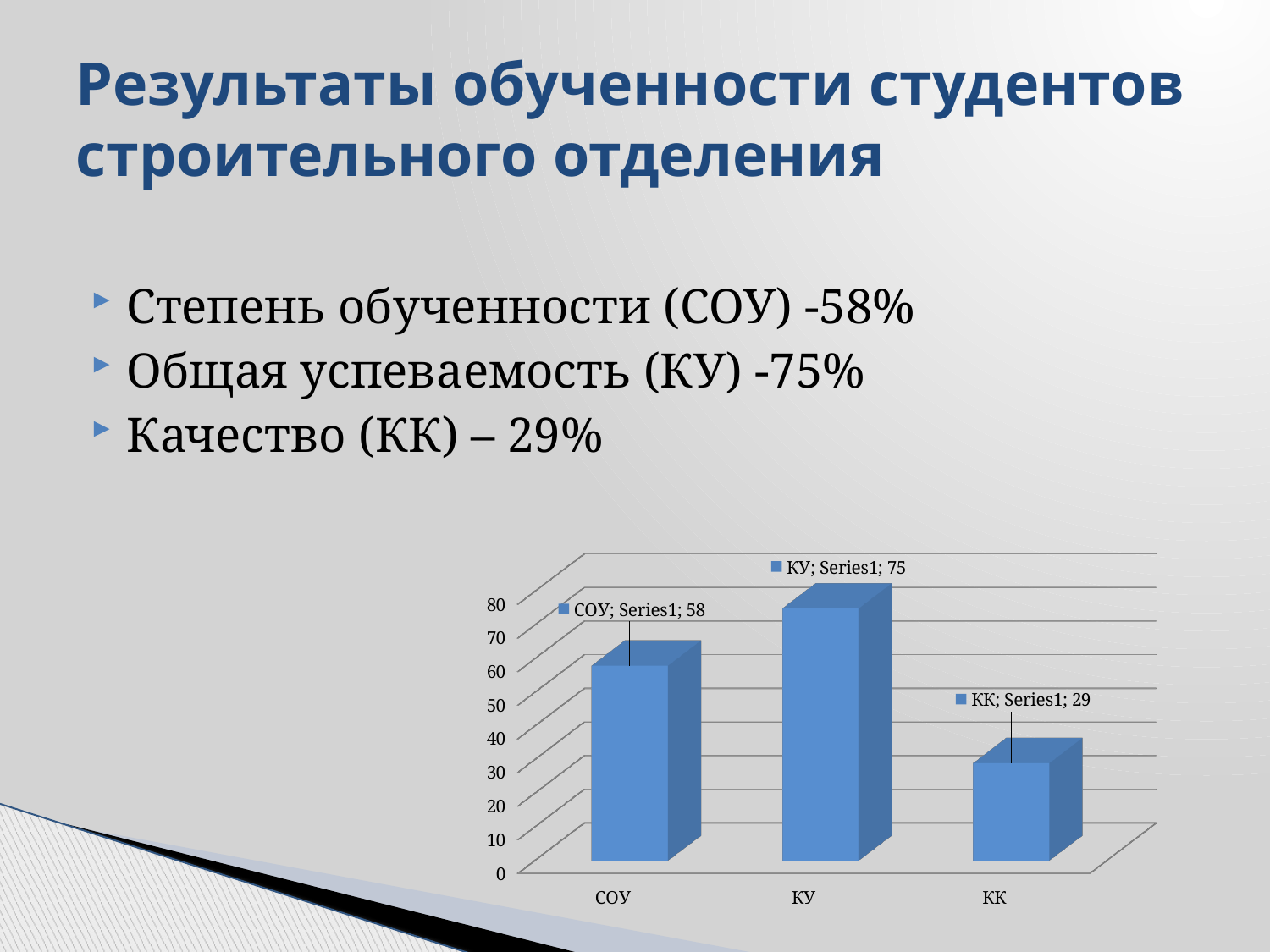
Which category has the highest value in the chart? КУ What is the value for СОУ in the chart? 58 What is the difference between the values for СОУ and КК? 29 Which is larger, the value for СОУ or the value for КК? СОУ What is the value for КУ in the chart? 75 What is the highest value shown on the vertical axis of the chart? 80 What is the difference between the values for КУ and СОУ? 17 How many categories are shown in the chart? 3 Is the value for КУ greater or less than 70? greater Which category has the lowest value in the chart? КК What is the value for КК in the chart? 29 What kind of chart is shown on the slide? bar chart